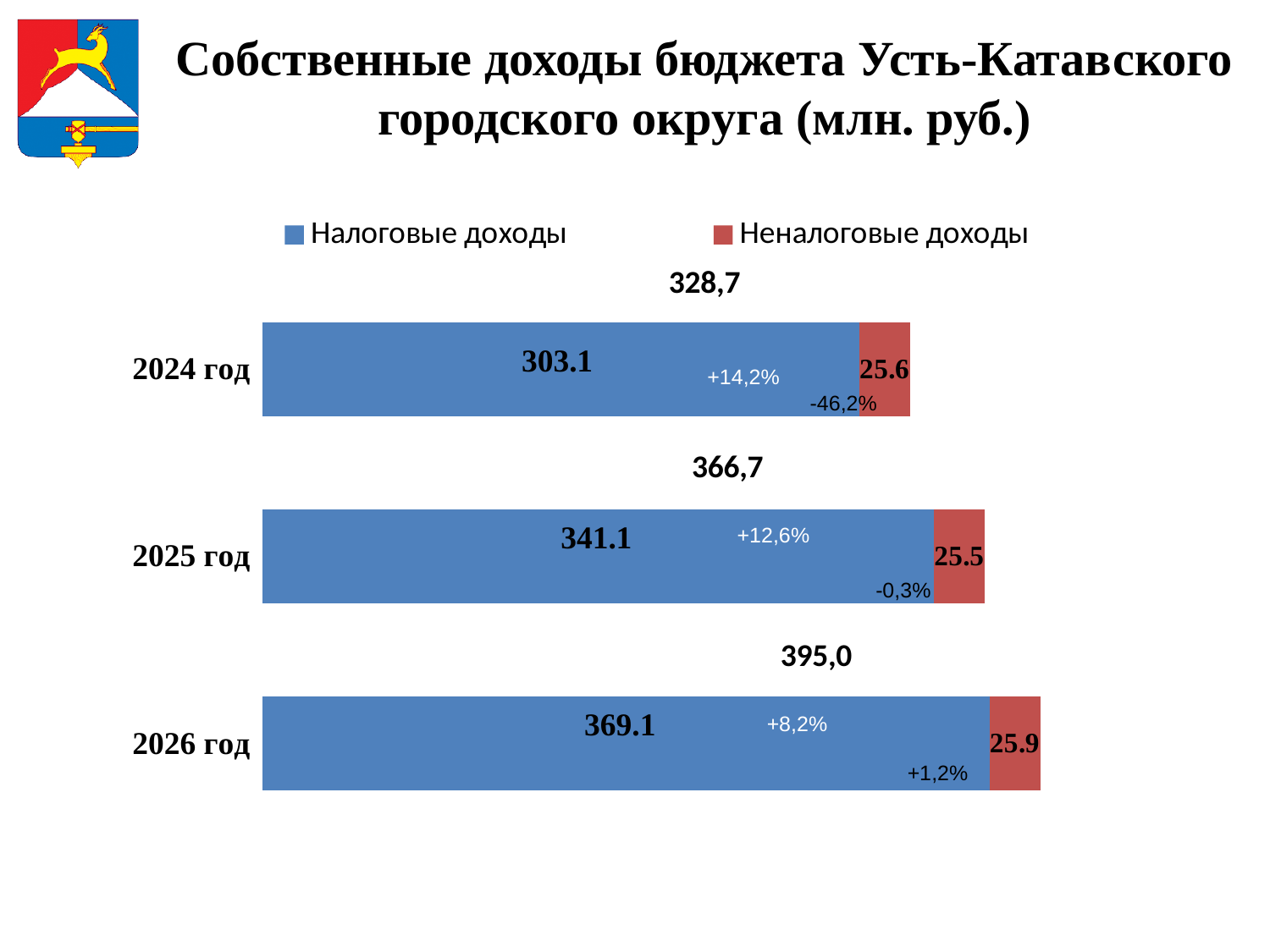
What is the value of Налоговые доходы for 2026 год? 369.1 What is the difference between Налоговые доходы in 2025 год and 2024 год? 38.0 What is the total shown for the 2025 год bar? 366,7 What is the value of Налоговые доходы for 2024 год? 303.1 How many years (categories) are shown in the chart? 3 Which year has the lowest value of Неналоговые доходы? 2025 год How many series does the legend list? 2 What is the total shown for the 2026 год bar? 395,0 What is the value of Неналоговые доходы for 2025 год? 25.5 Which year has the highest value of Налоговые доходы? 2026 год What type of chart is shown on the slide? bar chart Do the total values rise or fall from 2024 год to 2026 год? rise